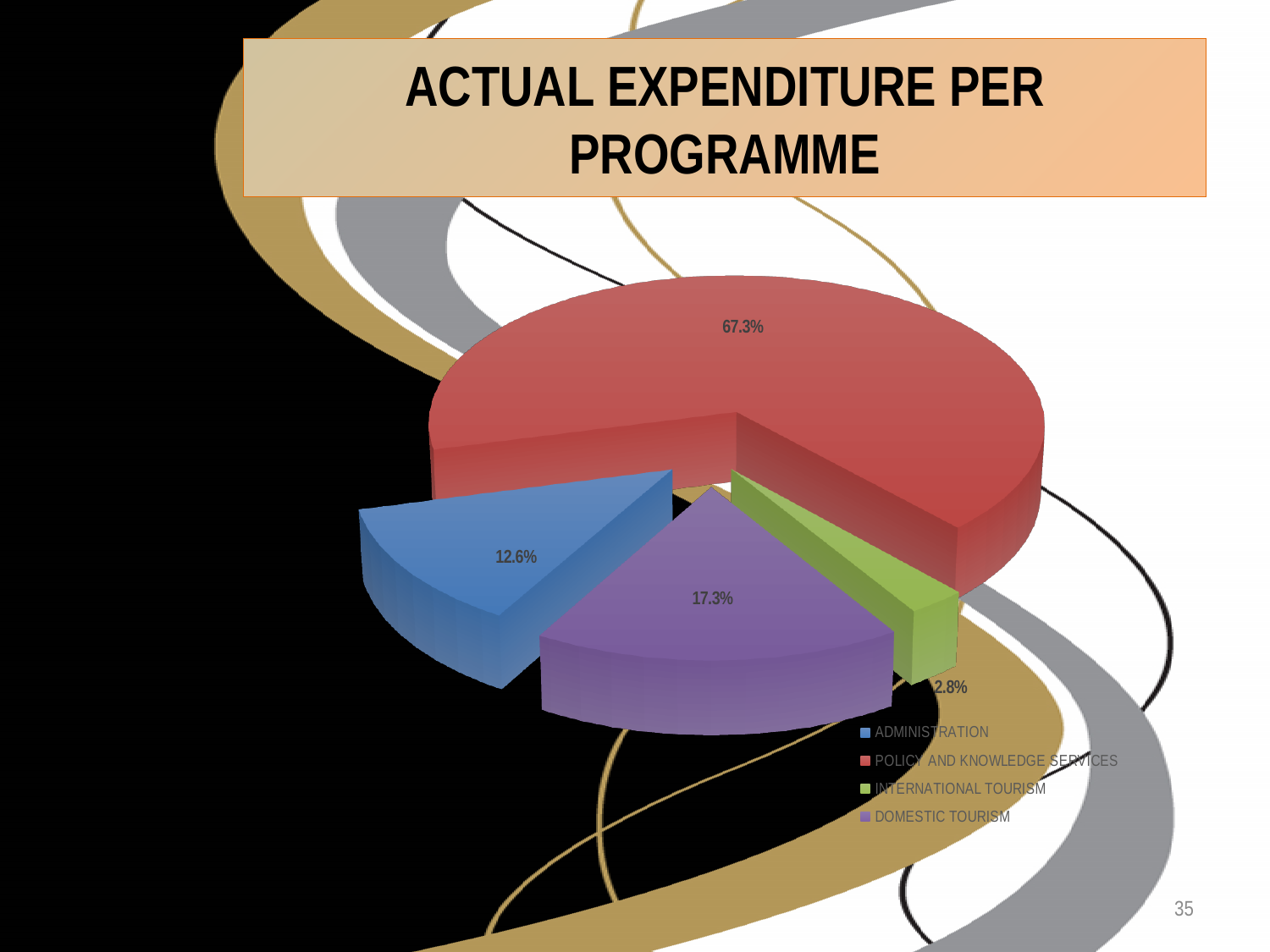
Which programme has the smallest share of actual expenditure? International Tourism What share of actual expenditure goes to Policy and Knowledge Services? 67.3% What is the difference in percentage points between the Domestic Tourism and Administration shares? 4.7 How many programmes are shown in the pie chart? 4 What is the title of the chart on the slide? ACTUAL EXPENDITURE PER PROGRAMME What kind of chart is shown on the slide? Pie chart Which programme has the largest share of actual expenditure? Policy and Knowledge Services What share of actual expenditure goes to Domestic Tourism? 17.3% Which colour represents Policy and Knowledge Services in the pie chart? Red Which has a larger share of expenditure, Administration or Domestic Tourism? Domestic Tourism What share of actual expenditure goes to International Tourism? 2.8% What share of actual expenditure goes to Administration? 12.6%